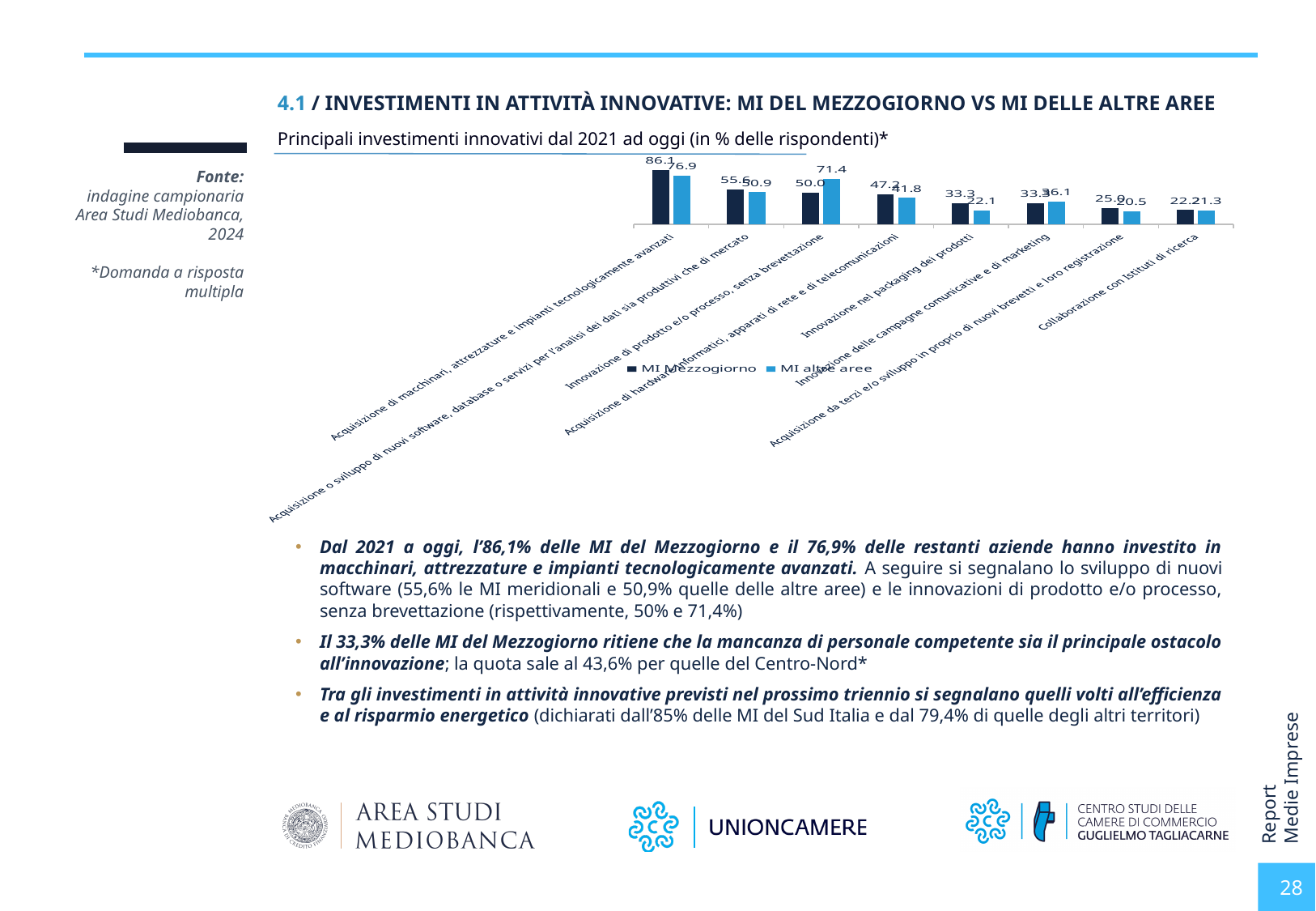
For 'Innovazione di prodotto e/o processo, senza brevettazione', which series has the larger value, MI Mezzogiorno or MI altre aree? MI altre aree What is the value for MI altre aree for 'Innovazione di prodotto e/o processo, senza brevettazione'? 71.4 What is the value for MI Mezzogiorno for 'Acquisizione di macchinari, attrezzature e impianti tecnologicamente avanzati'? 86.1 Which series is shown in dark navy bars? MI Mezzogiorno What type of chart is shown on the slide? bar chart How many series does the legend list? 2 What is the difference between MI Mezzogiorno and MI altre aree for 'Acquisizione di macchinari, attrezzature e impianti tecnologicamente avanzati'? 9.2 For 'Innovazione nel packaging dei prodotti', which series has the larger value, MI Mezzogiorno or MI altre aree? MI Mezzogiorno How many investment categories are plotted on the chart? 8 Which category has the lowest value for MI altre aree? Acquisizione da terzi e/o sviluppo in proprio di nuovi brevetti e loro registrazione What is the value for MI altre aree for 'Acquisizione di hardware informatici, apparati di rete e di telecomunicazioni'? 41.8 Which category has the highest value for MI Mezzogiorno? Acquisizione di macchinari, attrezzature e impianti tecnologicamente avanzati